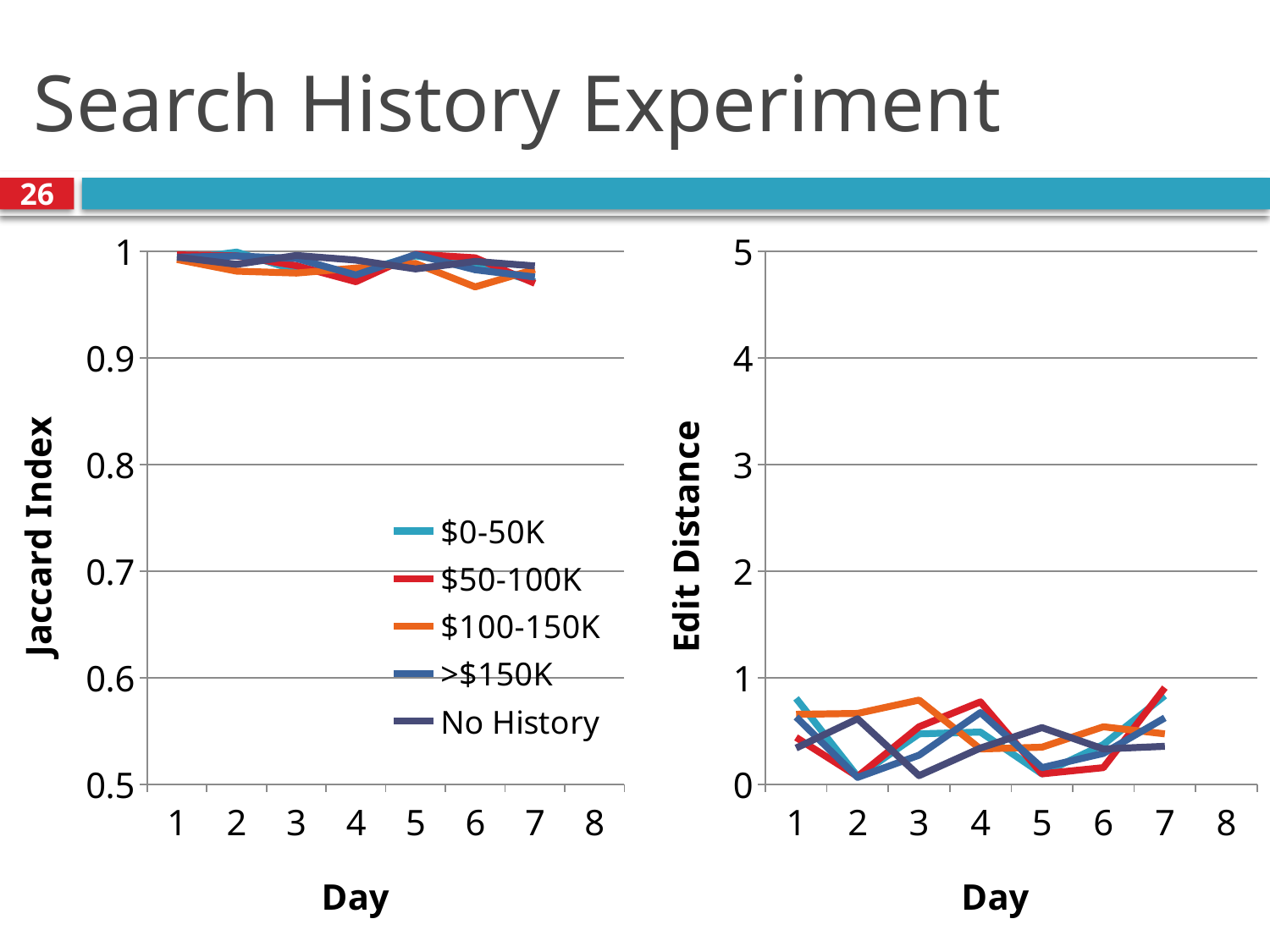
On the right chart (Edit Distance), is the value for >$150K at day 2 greater or less than 1? less How many series does the legend on the left chart list? 5 On the left chart (Jaccard Index), is the value for No History at day 1 greater or less than 0.9? greater What is the y-axis label of the left chart? Jaccard Index On the left chart (Jaccard Index), does the $100-150K line rise or fall from day 1 to day 7? fall On the right chart (Edit Distance), is the value for $100-150K at day 4 greater or less than 1? less What kind of chart is the right chart (Edit Distance)? line chart What kind of chart is the left chart (Jaccard Index)? line chart On the right chart (Edit Distance), how many days have data points plotted for each series? 7 What is the y-axis label of the right chart? Edit Distance